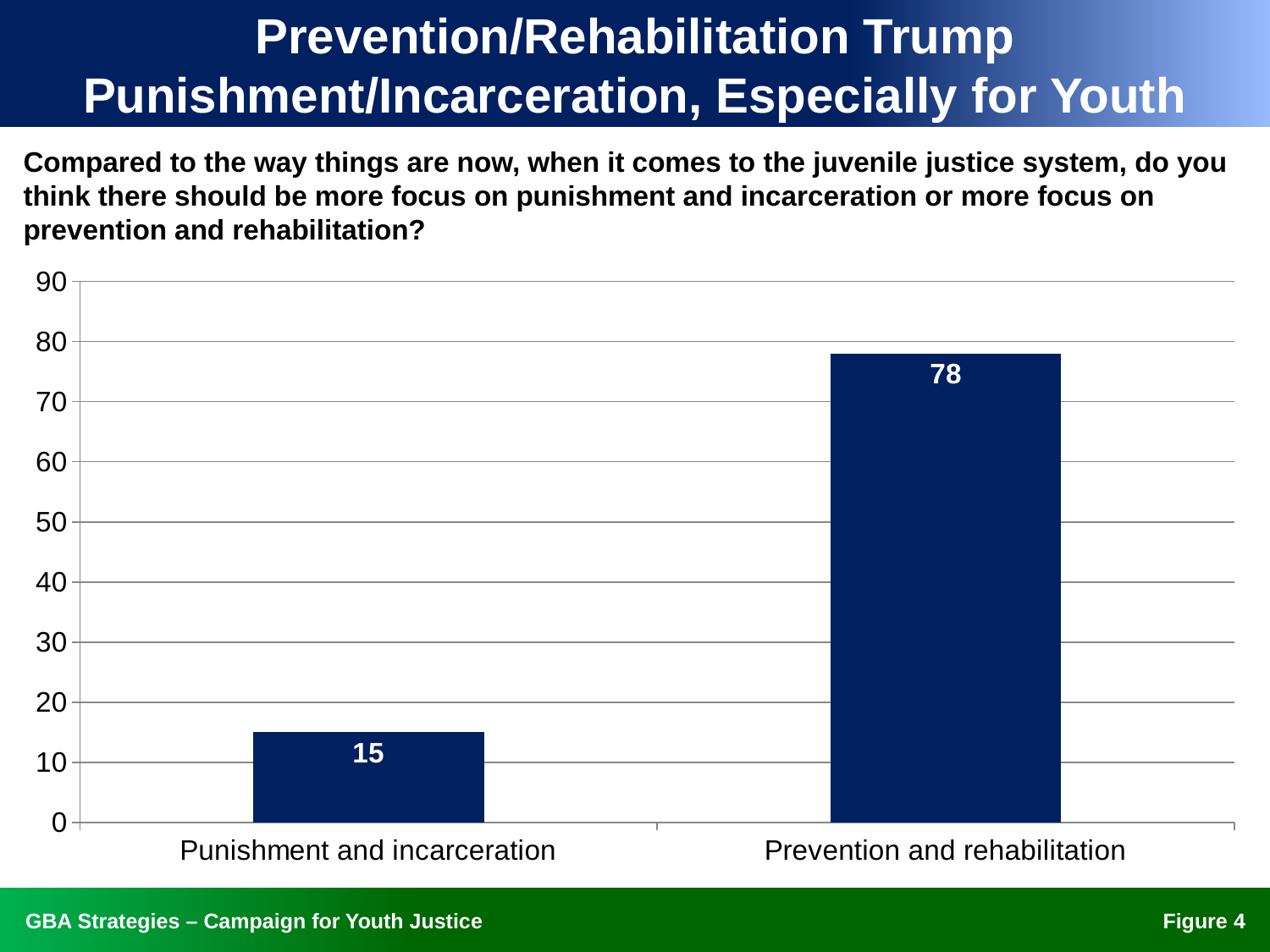
Is the value for Prevention and rehabilitation greater or less than 70? greater What is the difference between the values for Prevention and rehabilitation and Punishment and incarceration? 63 Which category has the lowest value? Punishment and incarceration Which category has the highest value? Prevention and rehabilitation What kind of chart is shown on the slide? Bar chart What is the value for Punishment and incarceration? 15 What is the highest value shown on the vertical axis? 90 How many categories are shown on the chart? 2 What is the value for Prevention and rehabilitation? 78 Which is larger, the value for Punishment and incarceration or the value for Prevention and rehabilitation? Prevention and rehabilitation What is the title of the slide? Prevention/Rehabilitation Trump Punishment/Incarceration, Especially for Youth Is the value for Punishment and incarceration greater or less than 20? less